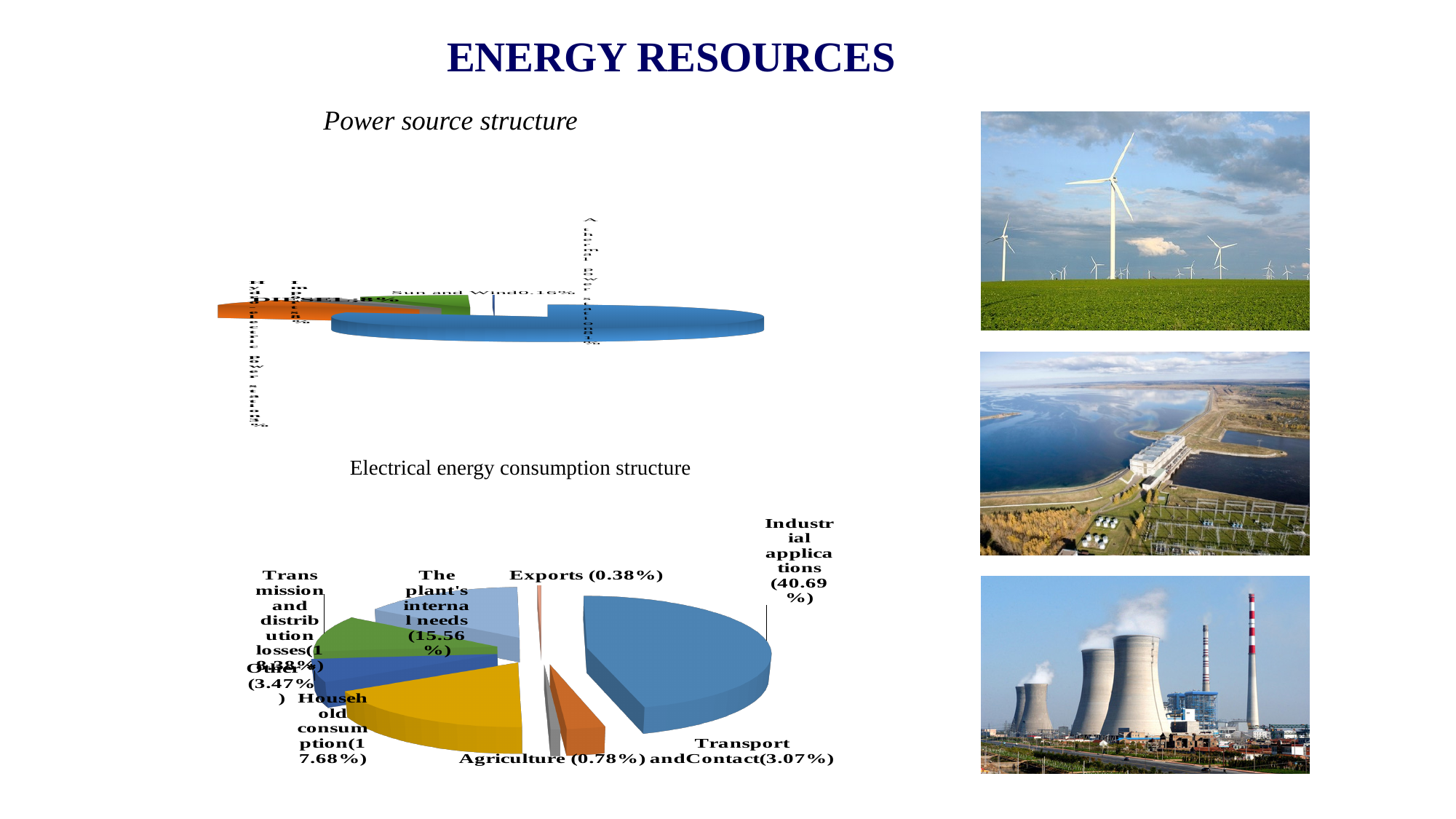
In the Electrical energy consumption structure chart, which category has the smallest share? Exports In the Electrical energy consumption structure chart, what share is Transport and Contact? 3.07% In the Electrical energy consumption structure chart, what share is Household consumption? 17.68% In the Electrical energy consumption structure chart, what share is Agriculture? 0.78% In the Electrical energy consumption structure chart, what share is Industrial applications? 40.69% In the Electrical energy consumption structure chart, which category has the largest share? Industrial applications In the Electrical energy consumption structure chart, what share is The plant's internal needs? 15.56% In the Electrical energy consumption structure chart, how many percentage points larger is Industrial applications than Household consumption? 23.01 In the Power source structure chart, what share is Sun and Wind? 0.16% In the Electrical energy consumption structure chart, what share is Exports? 0.38% In the Electrical energy consumption structure chart, which is larger: Household consumption or The plant's internal needs? Household consumption What kind of chart is the Electrical energy consumption structure chart? Pie chart